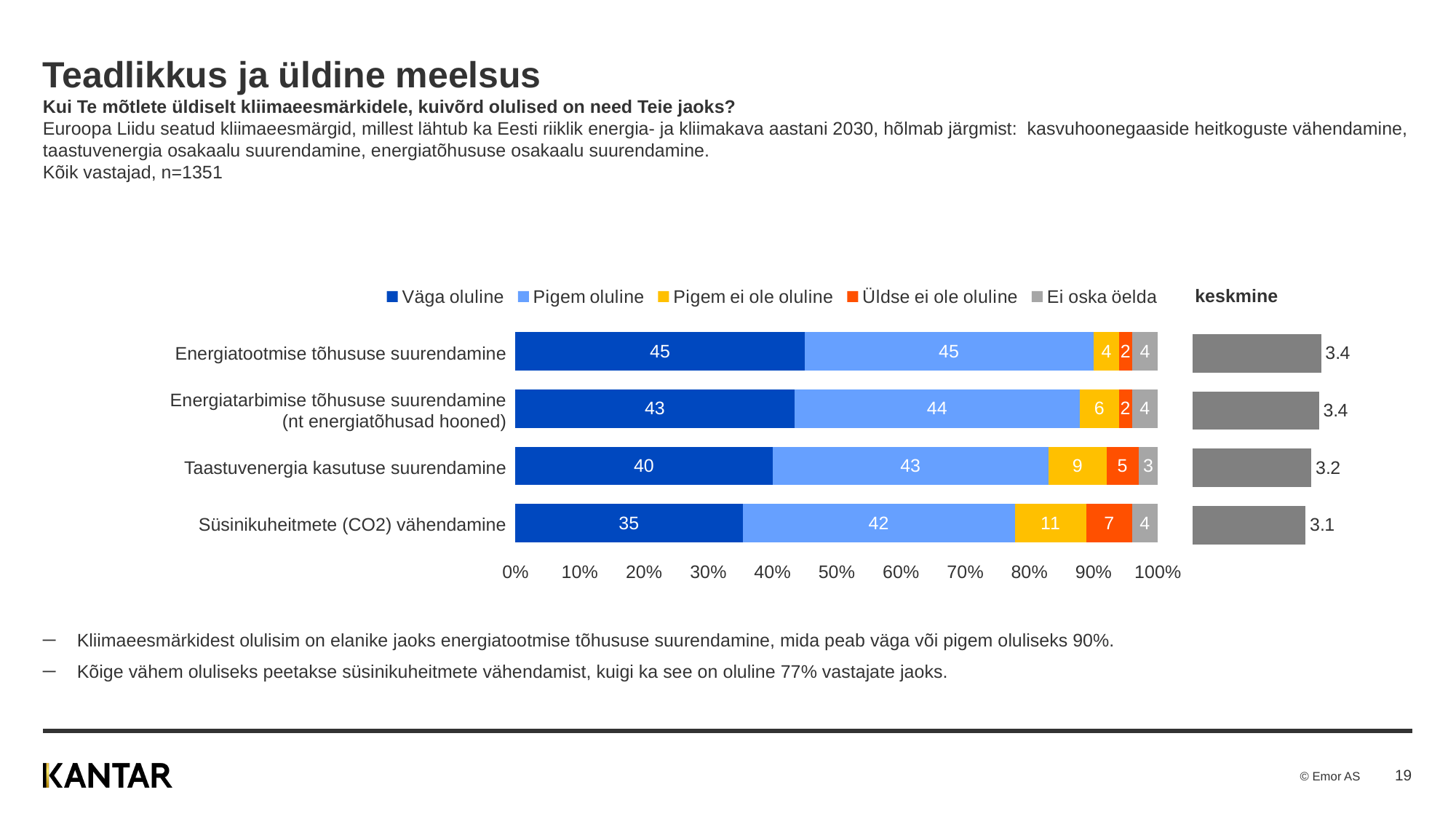
What kind of chart is used to show the responses on this slide? stacked bar chart In the stacked bar chart, which category has the lowest 'Pigem oluline' value? Süsinikuheitmete (CO2) vähendamine In the stacked bar chart, what is the 'Pigem ei ole oluline' value for 'Taastuvenergia kasutuse suurendamine'? 9 In the stacked bar chart, which category has the highest 'Väga oluline' value? Energiatootmise tõhususe suurendamine In the stacked bar chart, what is the 'Üldse ei ole oluline' value for 'Energiatarbimise tõhususe suurendamine (nt energiatõhusad hooned)'? 2 How many series does the legend of the stacked bar chart list? 5 In the 'keskmine' chart, which category has the lowest value? Süsinikuheitmete (CO2) vähendamine In the 'keskmine' chart, what is the value for 'Taastuvenergia kasutuse suurendamine'? 3.2 In the stacked bar chart, what is the 'Väga oluline' value for 'Süsinikuheitmete (CO2) vähendamine'? 35 In the stacked bar chart, which is larger: the 'Pigem ei ole oluline' value for 'Süsinikuheitmete (CO2) vähendamine' or for 'Energiatootmise tõhususe suurendamine'? Süsinikuheitmete (CO2) vähendamine In the stacked bar chart, what is the difference between the 'Väga oluline' values for 'Energiatootmise tõhususe suurendamine' and 'Süsinikuheitmete (CO2) vähendamine'? 10 How many categories are shown in the stacked bar chart? 4